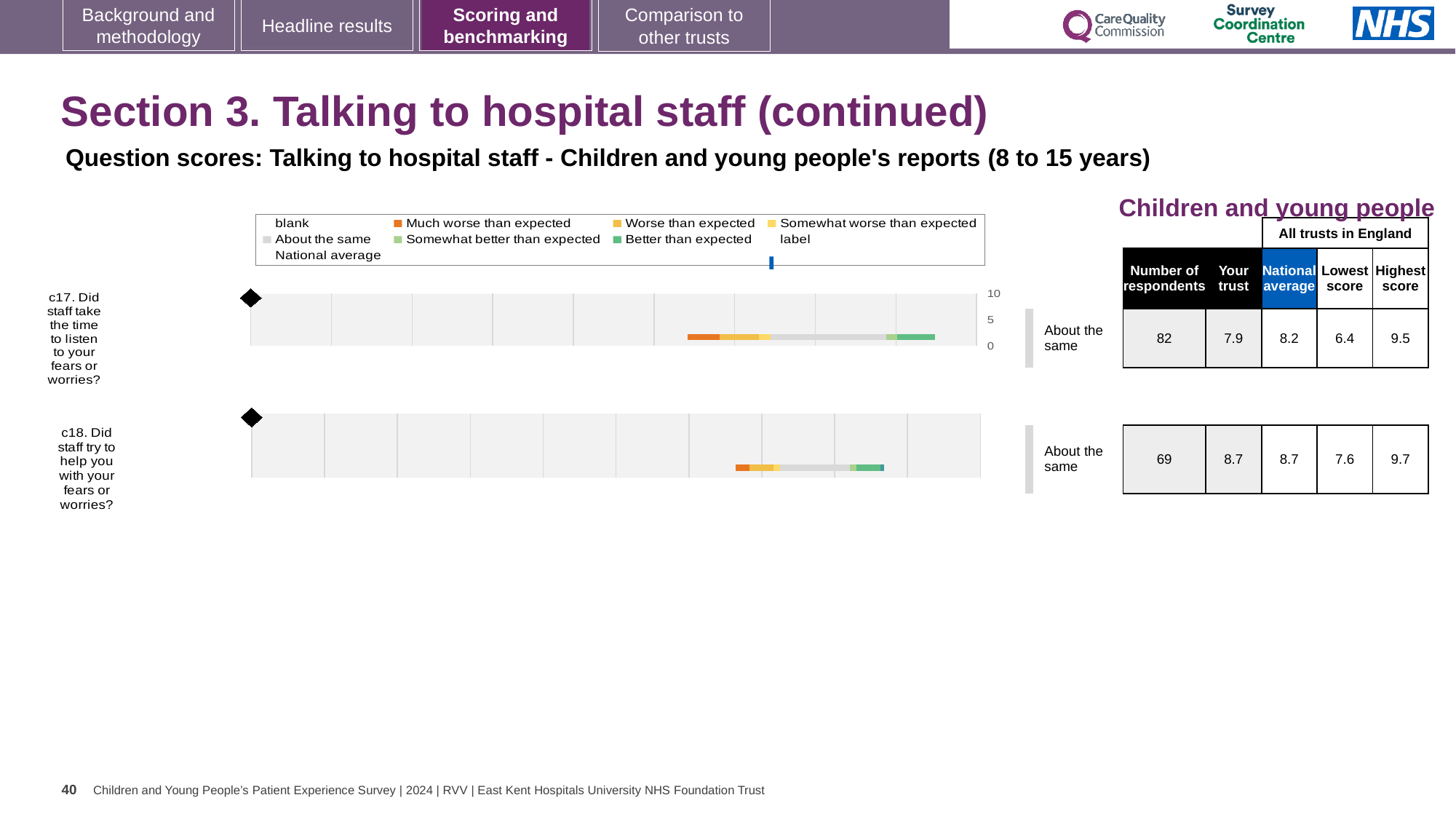
Which question has the higher 'Your trust' score, c17 or c18? c18 How many respondents are listed for c18? 69 How many entries does the chart legend list? 9 What kind of chart is used for question c17 on this slide? bar chart What colour does the legend use for 'Much worse than expected'? orange For c18 (Did staff try to help you with your fears or worries?), what is the 'Your trust' score shown in the table? 8.7 What is the highest score across all trusts in England for c17? 9.5 How many question charts (c17 and c18) are shown on the slide? 2 For c17 (Did staff take the time to listen to your fears or worries?), what is the 'Your trust' score shown in the table? 7.9 What is the difference between the highest and lowest trust scores for c18? 2.1 For c17, what is the national average score shown in the table? 8.2 What benchmark category is shown next to the c17 chart? About the same